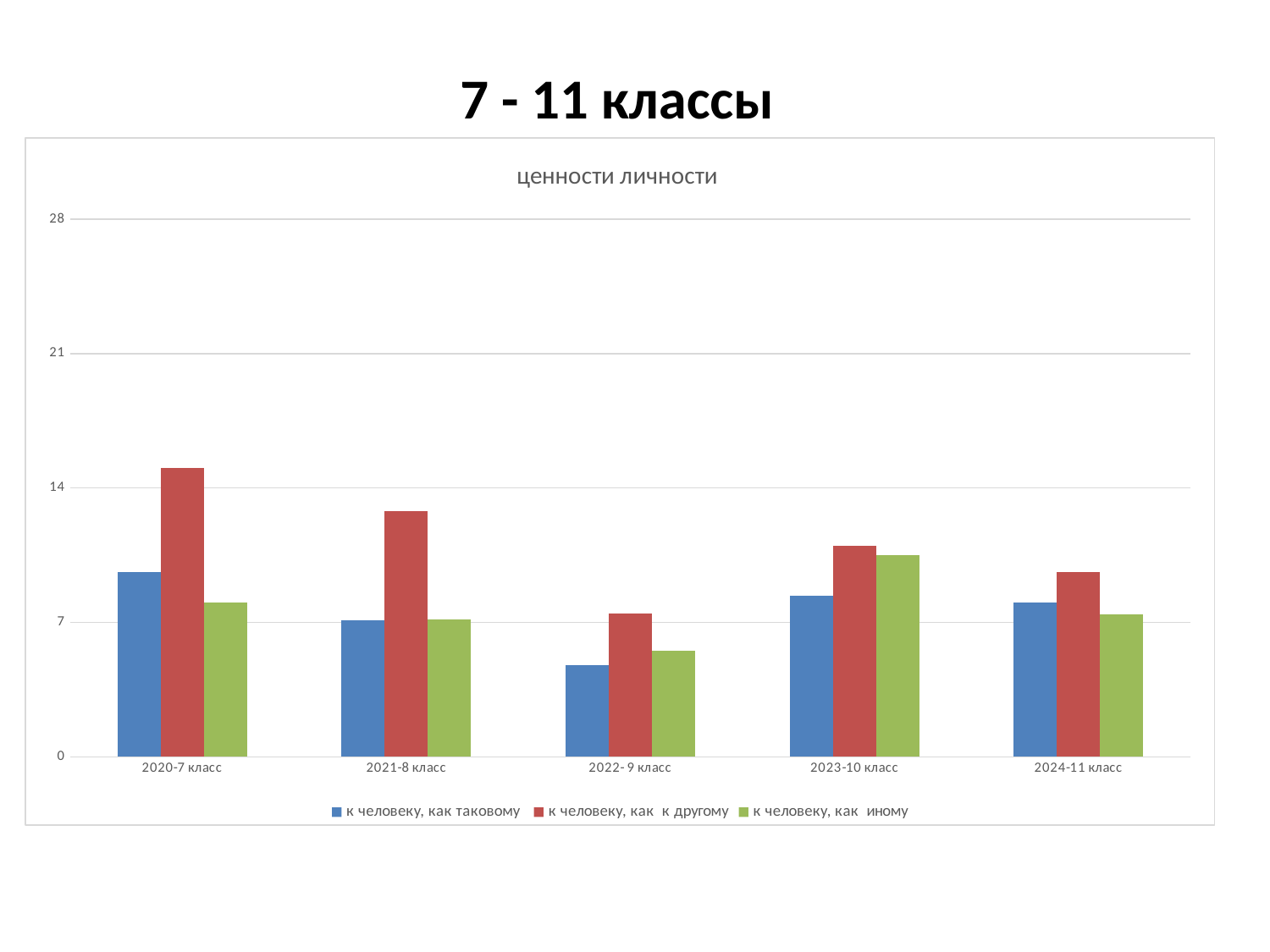
Is the value for 'к человеку, как к другому' in 2021-8 класс greater or less than 14? less Is the value for 'к человеку, как иному' in 2023-10 класс greater or less than 7? greater How many categories are shown on the x axis? 5 For which category is the value of 'к человеку, как таковому' the lowest? 2022- 9 класс What kind of chart is shown on the slide? bar chart What is the title of the chart? ценности личности In 2020-7 класс, which is larger: 'к человеку, как к другому' or 'к человеку, как иному'? к человеку, как к другому How many series does the legend list? 3 Does the value of 'к человеку, как к другому' rise or fall from 2020-7 класс to 2022- 9 класс? fall For which category is the value of 'к человеку, как к другому' the highest? 2020-7 класс Is the value for 'к человеку, как к другому' in 2020-7 класс greater or less than 14? greater